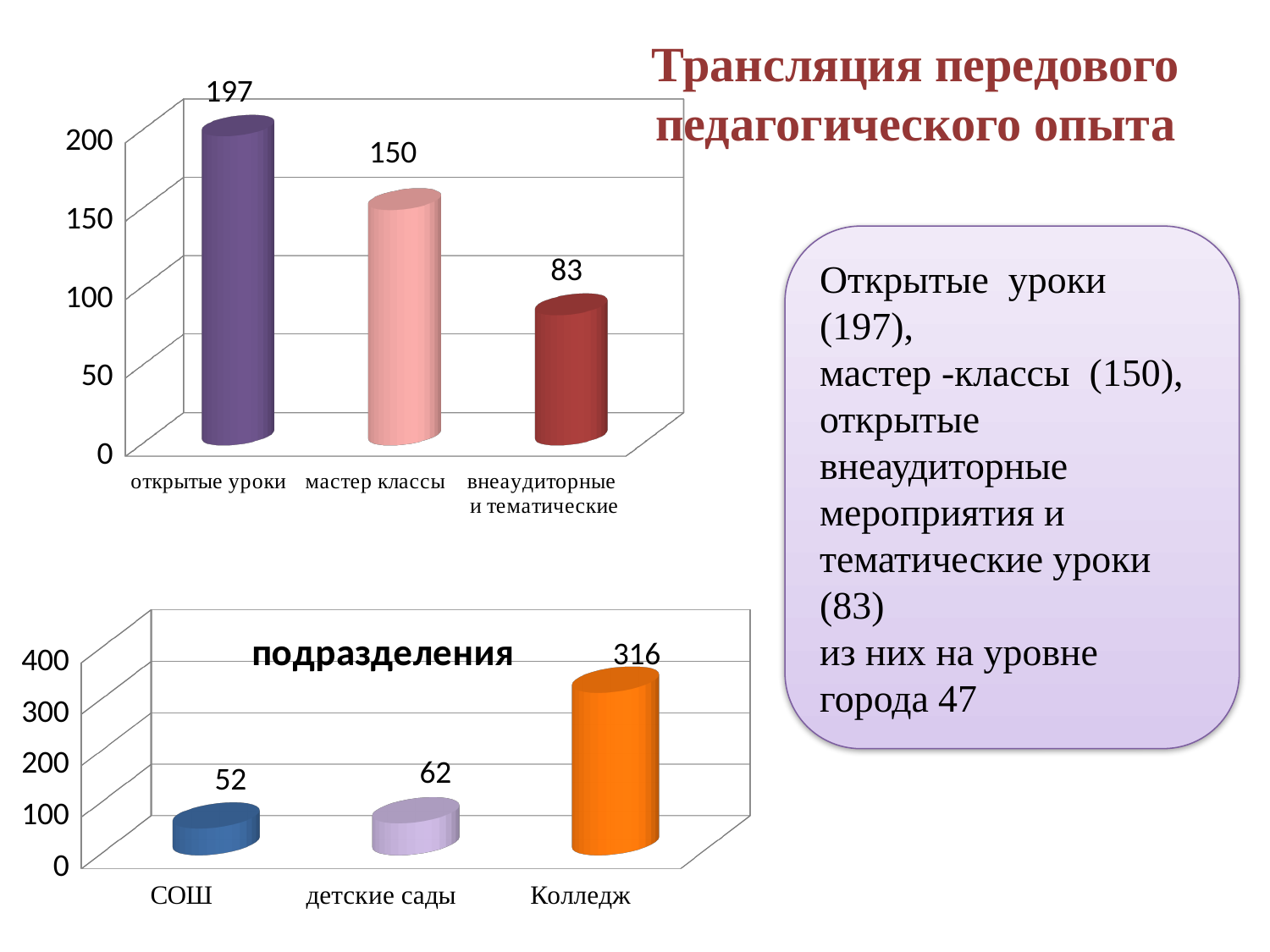
In the top chart, what is the value for мастер классы? 150 In the top chart, what kind of chart is it? bar chart In the top chart, which category has the lowest value? внеаудиторные и тематические In the top chart, do the values rise or fall from left to right? fall In the bottom chart titled подразделения, what is the value for Колледж? 316 In the top chart, what is the value for открытые уроки? 197 In the bottom chart titled подразделения, what is the difference between Колледж and СОШ? 264 In the bottom chart titled подразделения, which category has the highest value? Колледж In the top chart, how many categories are shown? 3 What is the title of the bottom chart? подразделения In the top chart, what is the difference between открытые уроки and мастер классы? 47 In the bottom chart titled подразделения, which is larger, СОШ or детские сады? детские сады